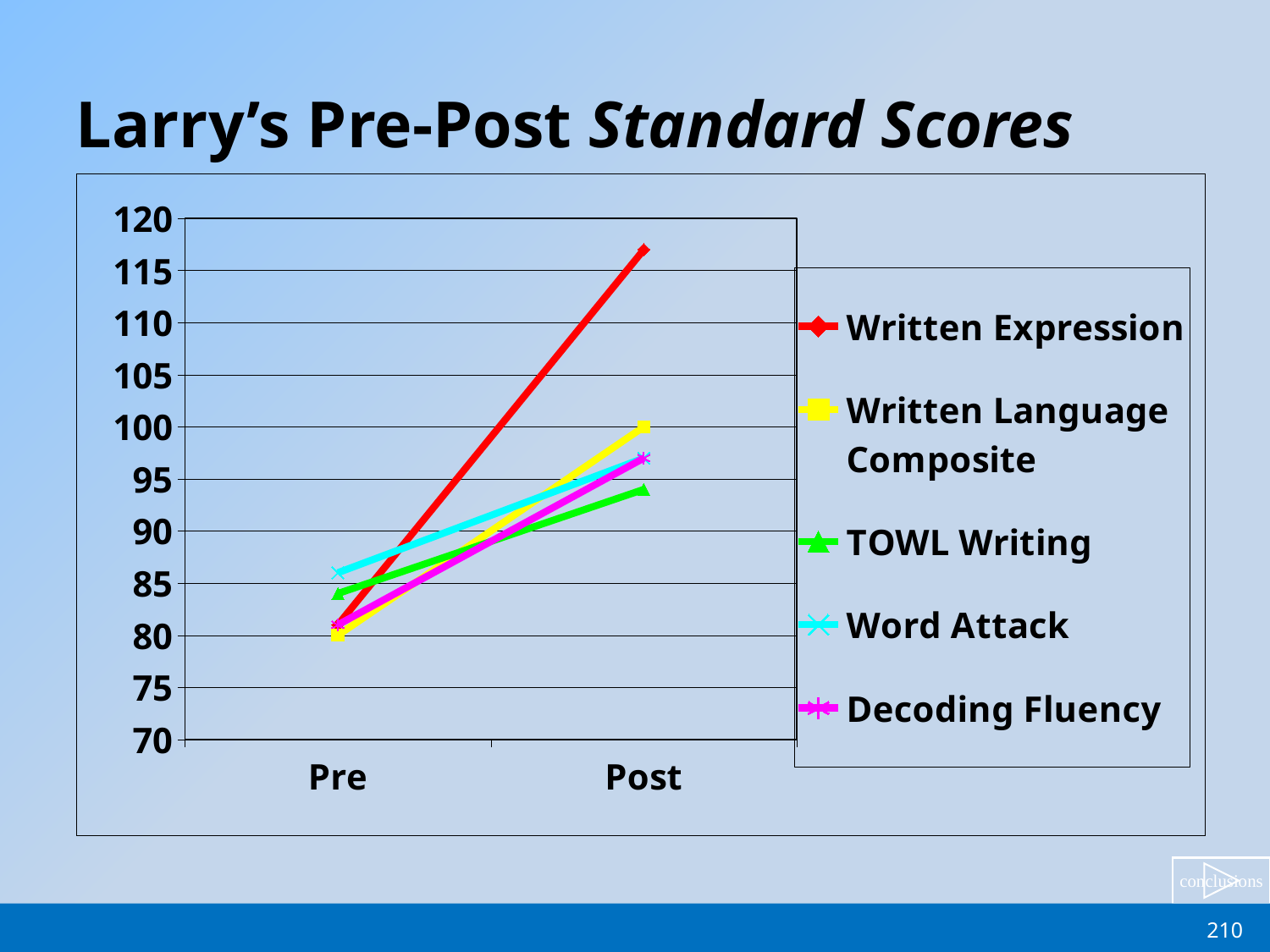
Which series has the lowest Post value? TOWL Writing Which series is drawn in red? Written Expression How many series does the legend list? 5 What kind of chart is shown on the slide? line chart What is the Post value for Written Language Composite? 100 Is the Post value for Written Expression greater or less than 115? greater Is the Pre value for Word Attack greater or less than 90? less Is the Post value for TOWL Writing greater or less than 95? less Which series has the highest Post value? Written Expression What is the Pre value for Written Language Composite? 80 Do the scores rise or fall from Pre to Post for Written Expression? rise How many categories are shown on the x axis? 2